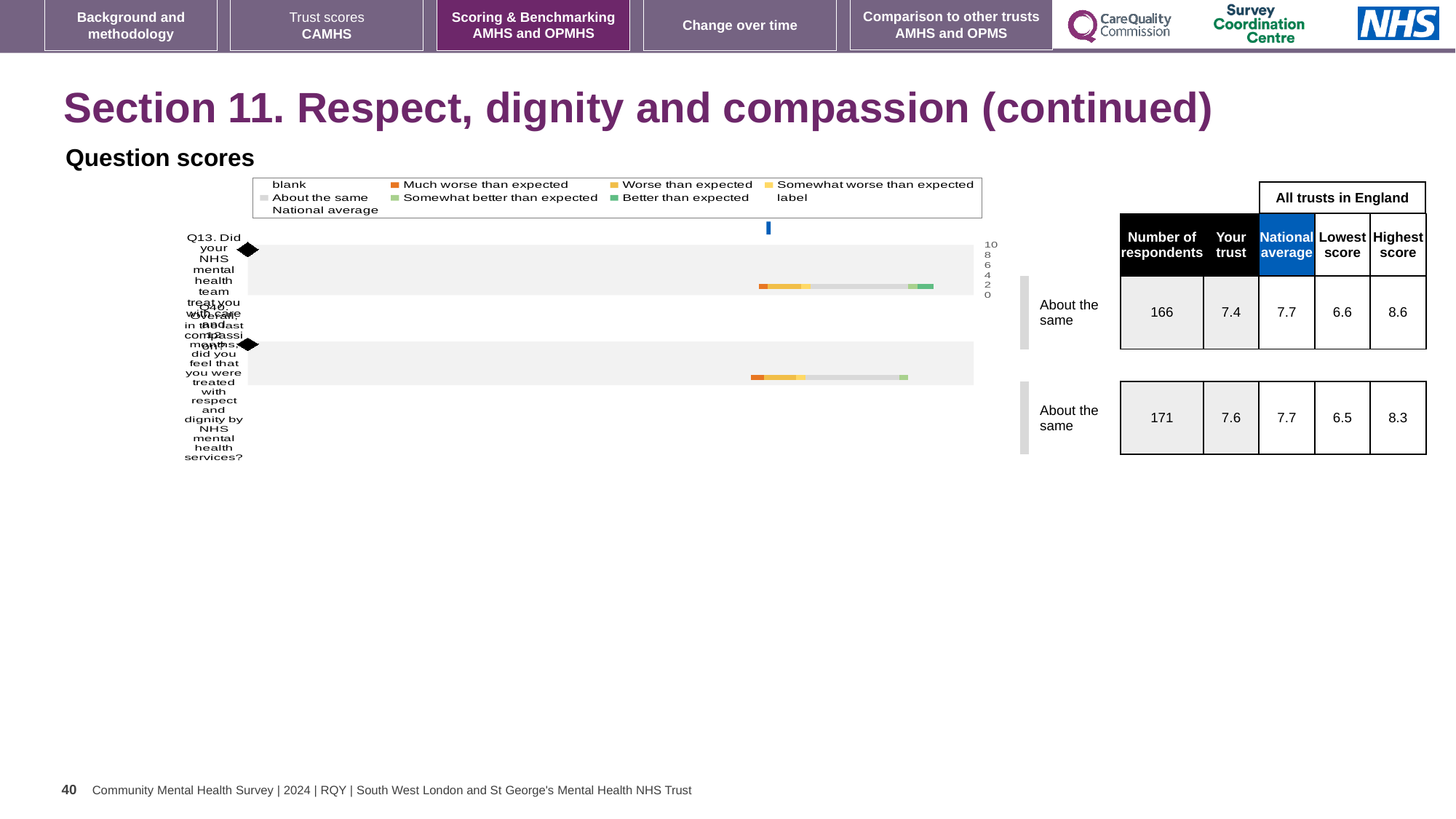
What is the difference between the highest and lowest scores for Q13? 2.0 Which question has the higher 'Your trust' score, Q13 or Q10? Q10 What type of chart is used to show the question scores on this slide? bar chart What is the highest score across all trusts in England for Q13? 8.6 How many questions are plotted in the question scores chart? 2 What is the 'Your trust' score for Q13 (care and compassion)? 7.4 What is the national average score for Q13? 7.7 Is the trust's score for Q10 higher or lower than the national average? lower How many respondents answered Q10? 171 What is the difference between the highest and lowest scores for Q10? 1.8 What is the 'Your trust' score for Q10 (respect and dignity)? 7.6 What benchmark category is shown for Q13 in the chart? About the same